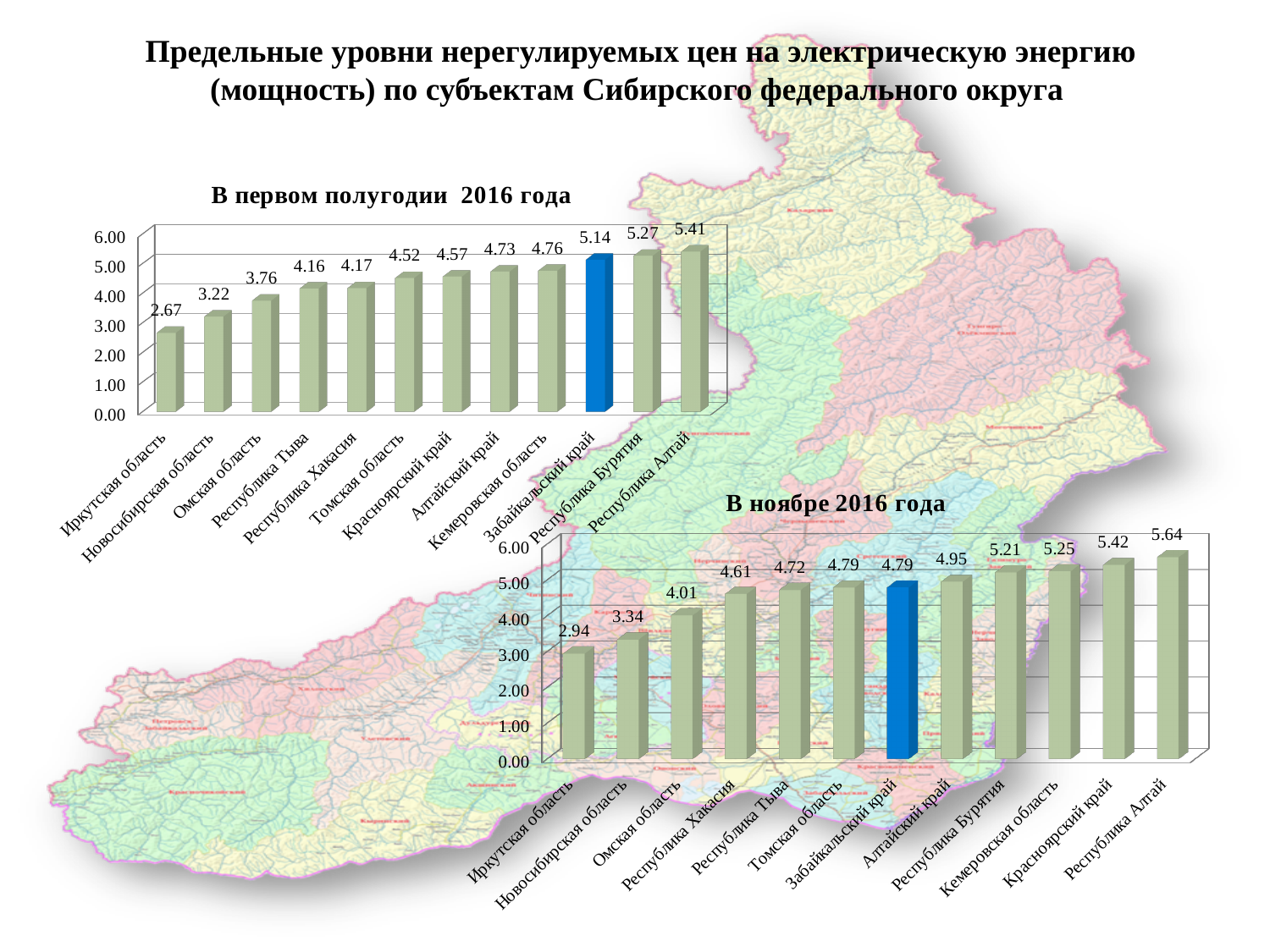
In the chart 'В ноябре 2016 года', what is the value for Омская область? 4.01 In the chart 'В ноябре 2016 года', which is larger: Республика Бурятия or Алтайский край? Республика Бурятия In the chart 'В ноябре 2016 года', what is the difference between Республика Алтай and Кемеровская область? 0.39 In the chart 'В ноябре 2016 года', what is the value for Красноярский край? 5.42 In the chart 'В ноябре 2016 года', do the values rise or fall from left to right along the x axis? rise What type of chart is 'В ноябре 2016 года'? bar chart In the chart 'В первом полугодии 2016 года', which category has the highest value? Республика Алтай In the chart 'В первом полугодии 2016 года', what is the value for Иркутская область? 2.67 In the chart 'В ноябре 2016 года', which category has the lowest value? Иркутская область In the chart 'В первом полугодии 2016 года', what is the difference between Республика Алтай and Иркутская область? 2.74 In the chart 'В первом полугодии 2016 года', what is the value for Забайкальский край? 5.14 In the chart 'В первом полугодии 2016 года', how many categories are shown? 12